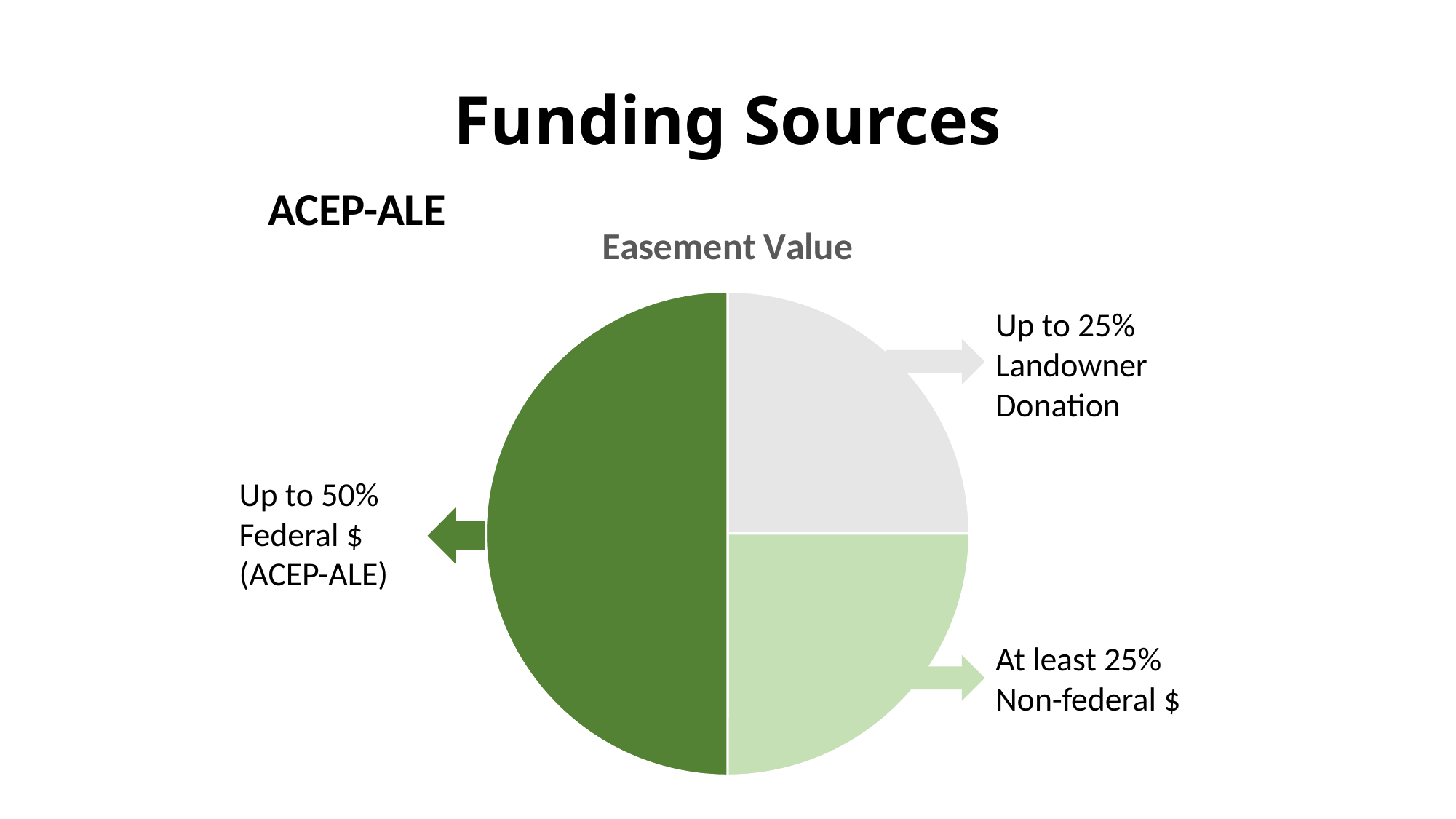
Which slice is shown in dark green? Federal $ (ACEP-ALE) Which is larger, the Federal $ (ACEP-ALE) slice or the Landowner Donation slice? Federal $ (ACEP-ALE) Is the Federal $ (ACEP-ALE) share greater or less than 40%? greater Which slice of the pie chart is the largest? Federal $ (ACEP-ALE) What is the difference in percentage points between the Federal $ (ACEP-ALE) share and the Non-federal $ share? 25% How many slices does the pie chart have? 3 What kind of chart is shown on the slide? Pie chart What is the title of the chart? Easement Value What share of the easement value is labelled for Non-federal $? At least 25% What share of the easement value is labelled for Landowner Donation? Up to 25% What share of the easement value is labelled for Federal $ (ACEP-ALE)? Up to 50%